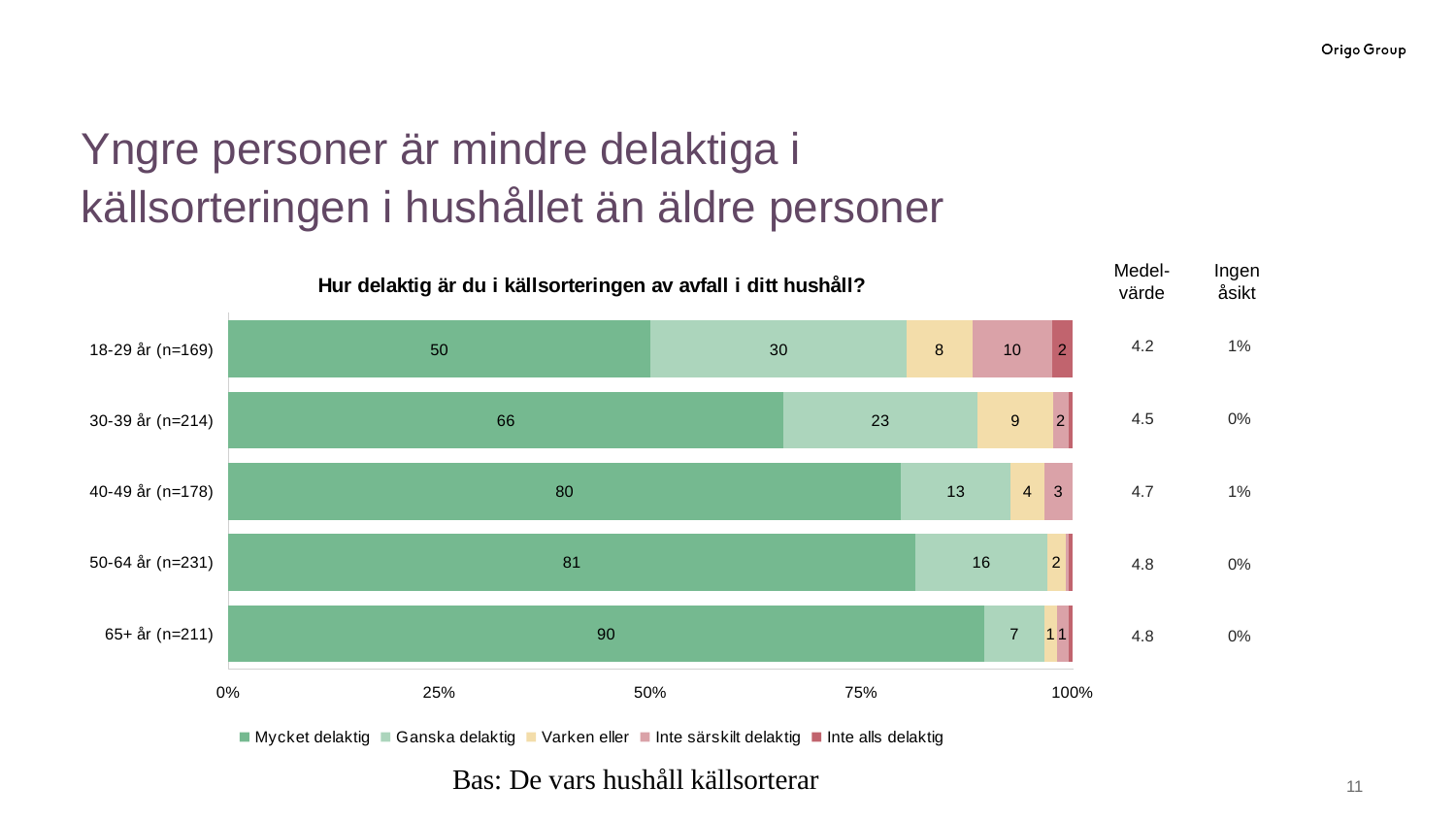
Does the 'Mycket delaktig' value for 'Mycket delaktig' rise or fall as the age groups get older? Rise How many age groups are plotted in the chart? 5 What is the value for 'Ganska delaktig' in the 30-39 år group? 23 What is the value for 'Mycket delaktig' in the 18-29 år group? 50 What is the difference between the 'Mycket delaktig' values for 65+ år and 18-29 år? 40 Which is larger: the 'Ganska delaktig' value for 40-49 år or for 50-64 år? 50-64 år Which age group has the lowest value for 'Mycket delaktig'? 18-29 år (n=169) Which age group has the highest value for 'Mycket delaktig'? 65+ år (n=211) How many series does the legend list? 5 What is the chart's title? Hur delaktig är du i källsorteringen av avfall i ditt hushåll? What kind of chart is shown on the slide? Stacked bar chart What is the value for 'Inte särskilt delaktig' in the 18-29 år group? 10